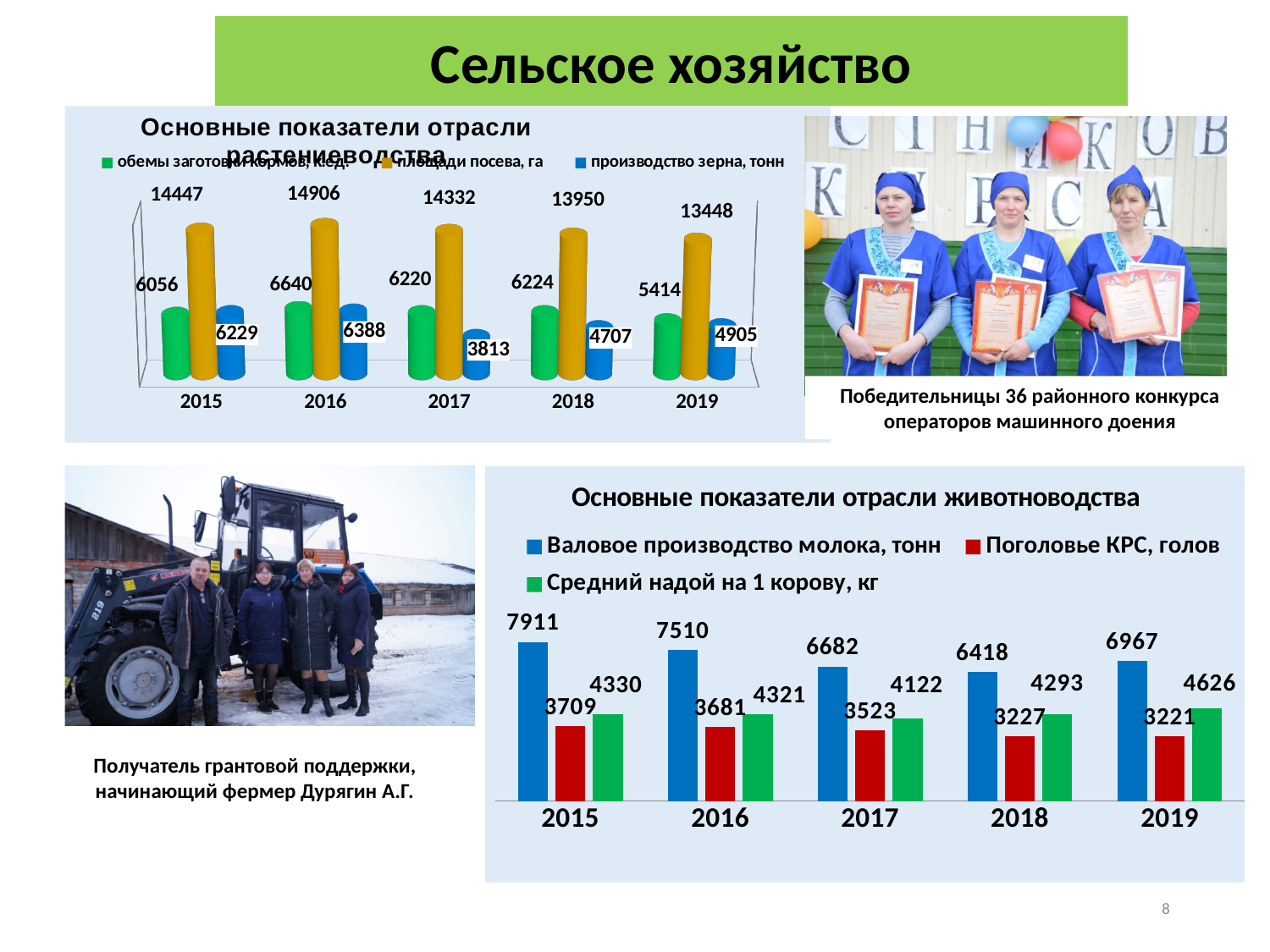
In the chart 'Основные показатели отрасли животноводства', what is the value of 'Средний надой на 1 корову, кг' for 2019? 4626 In the chart 'Основные показатели отрасли животноводства', does 'Поголовье КРС, голов' rise or fall from 2015 to 2019? fall In the chart 'Основные показатели отрасли животноводства', which year has the lowest value for 'Поголовье КРС, голов'? 2019 In the chart 'Основные показатели отрасли животноводства', what is the value of 'Валовое производство молока, тонн' for 2015? 7911 In the chart 'Основные показатели отрасли растениеводства', what is the value of the gold series for 2016? 14906 In the chart 'Основные показатели отрасли животноводства', what is the value of 'Поголовье КРС, голов' for 2018? 3227 In the chart 'Основные показатели отрасли растениеводства', which year has the lowest value for 'производство зерна, тонн'? 2017 In the chart 'Основные показатели отрасли растениеводства', how many years are shown on the x axis? 5 In the chart 'Основные показатели отрасли животноводства', what is the difference between 'Валовое производство молока, тонн' in 2015 and in 2016? 401 In the chart 'Основные показатели отрасли животноводства', which year has the highest value for 'Валовое производство молока, тонн'? 2015 In the chart 'Основные показатели отрасли растениеводства', what is the value of 'производство зерна, тонн' for 2017? 3813 In the chart 'Основные показатели отрасли животноводства', how many series does the legend list? 3